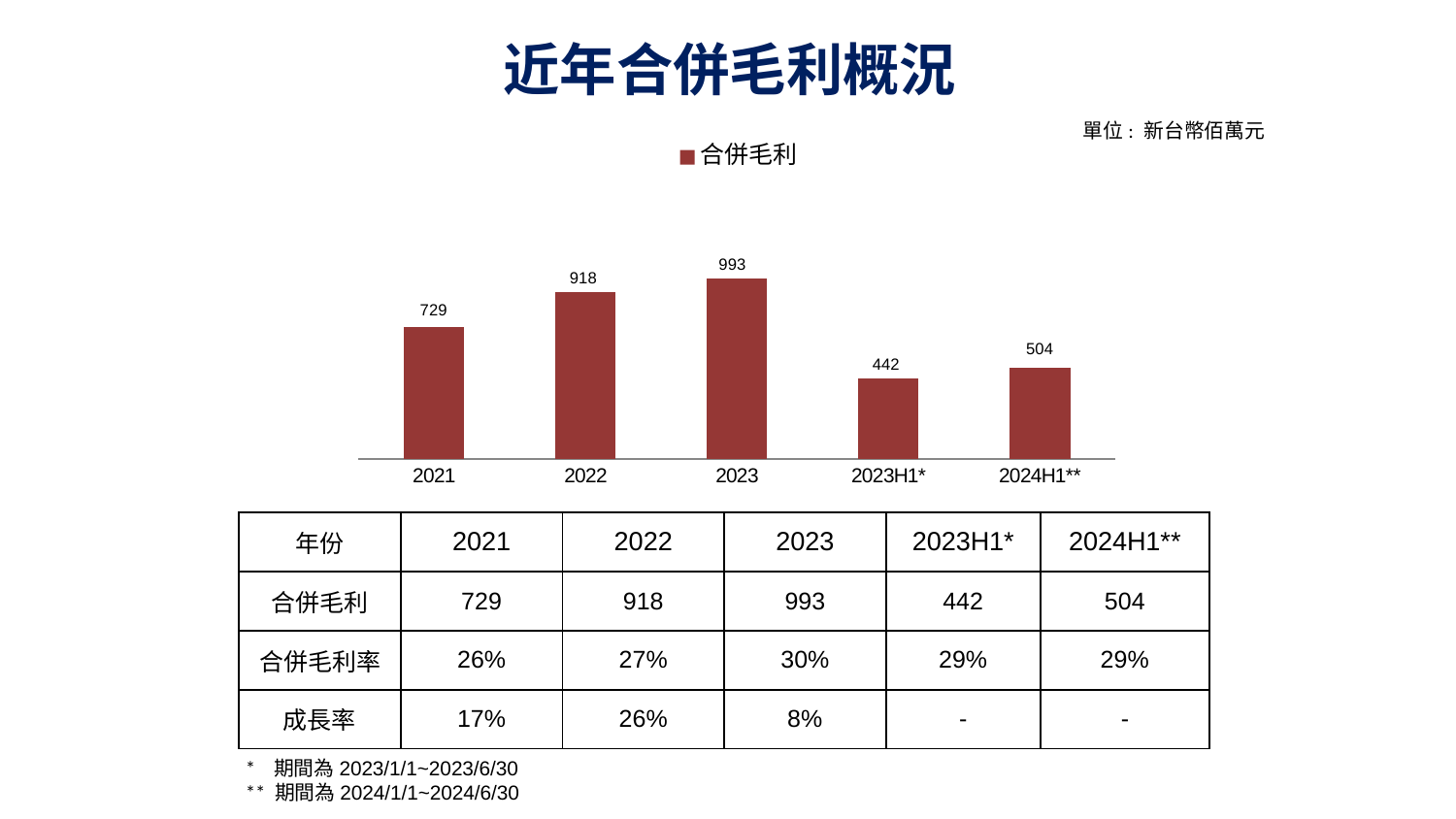
What is the value of 合併毛利 for 2021? 729 Which is larger, the 合併毛利 for 2021 or for 2022? 2022 What kind of chart is shown on the slide? bar chart Which category has the highest 合併毛利? 2023 How many categories are shown on the x axis of the chart? 5 Do the 合併毛利 values rise or fall from 2021 to 2023? rise What is the difference in 合併毛利 between 2023 and 2022? 75 What is the difference in 合併毛利 between 2024H1** and 2023H1*? 62 Which category has the lowest 合併毛利? 2023H1* What is the value of 合併毛利 for 2022? 918 What is the value of 合併毛利 for 2024H1**? 504 How many series does the legend list? 1